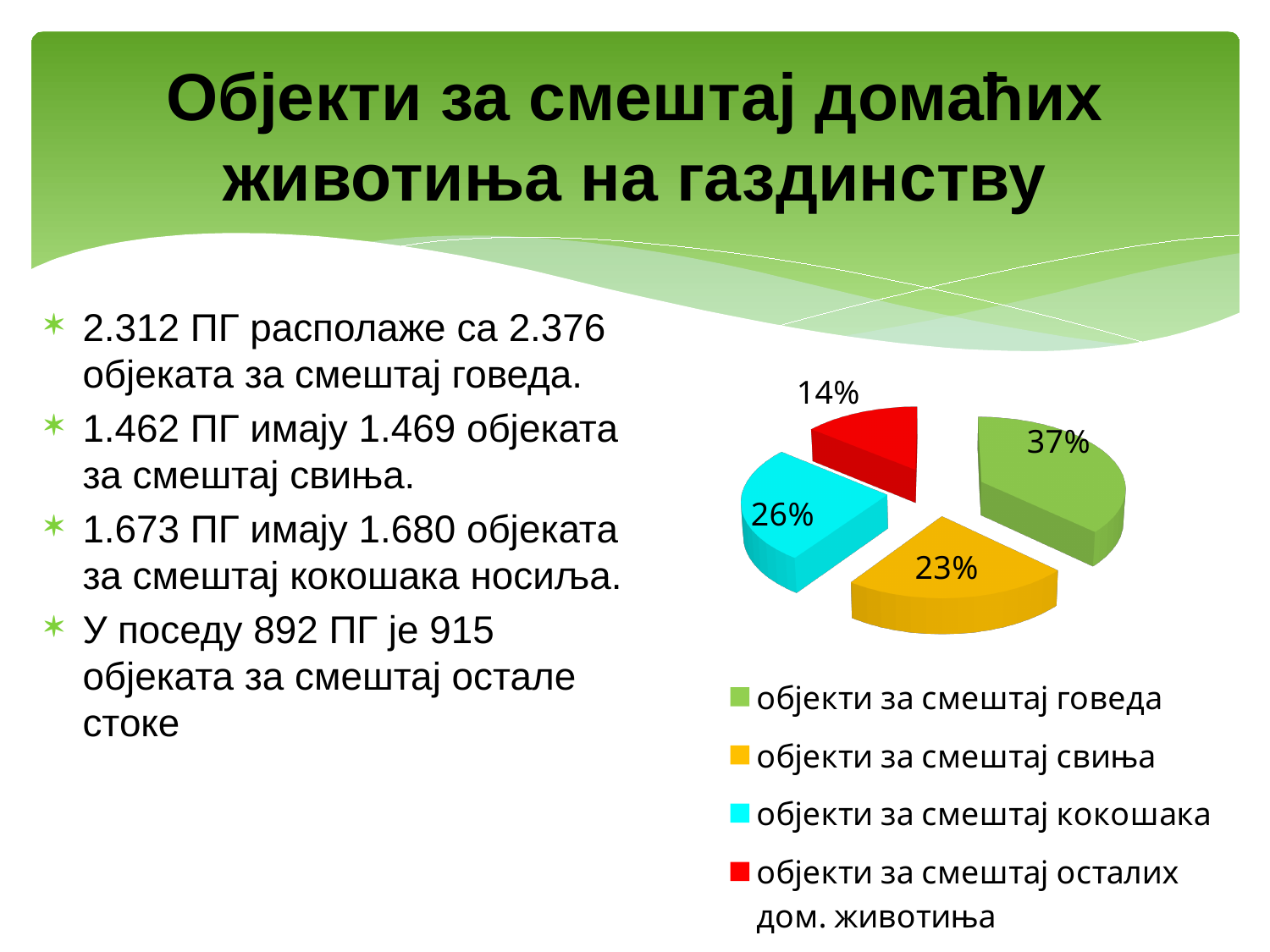
What share of the pie is labelled for објекти за смештај свиња? 23% What share of the pie is labelled for објекти за смештај кокошака? 26% Which category has the largest slice of the pie? објекти за смештај говеда What colour is the slice for објекти за смештај свиња? yellow How many entries does the legend list? 4 What share of the pie is labelled for објекти за смештај осталих дом. животиња? 14% How many slices does the pie chart have? 4 Which slice is larger: објекти за смештај кокошака or објекти за смештај свиња? објекти за смештај кокошака Which category has the smallest slice of the pie? објекти за смештај осталих дом. животиња What is the difference in percentage points between the slice for говеда and the slice for свиња? 14 What kind of chart is shown on the slide? pie chart